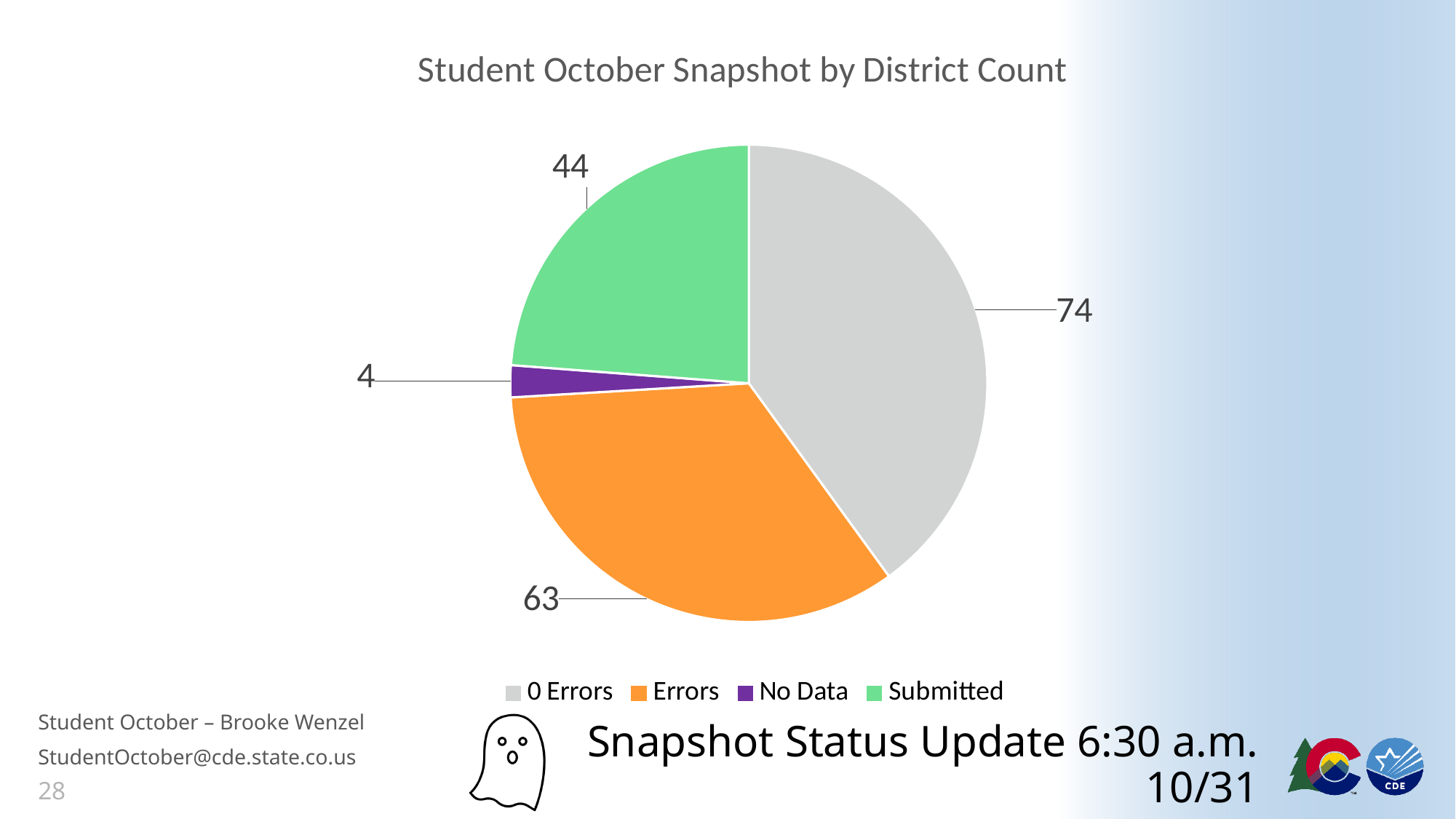
How many districts are in the Errors category? 63 What is the total number of districts across all four categories? 185 Which category has the smallest slice of the pie? No Data How many districts are in the No Data category? 4 What is the title of the chart? Student October Snapshot by District Count Which is larger, the Submitted count or the Errors count? Errors How many categories does the pie chart show? 4 Which category has the largest slice of the pie? 0 Errors What type of chart is shown on the slide? Pie chart How many districts are in the 0 Errors category? 74 How many districts are in the Submitted category? 44 What is the difference between the 0 Errors count and the Errors count? 11